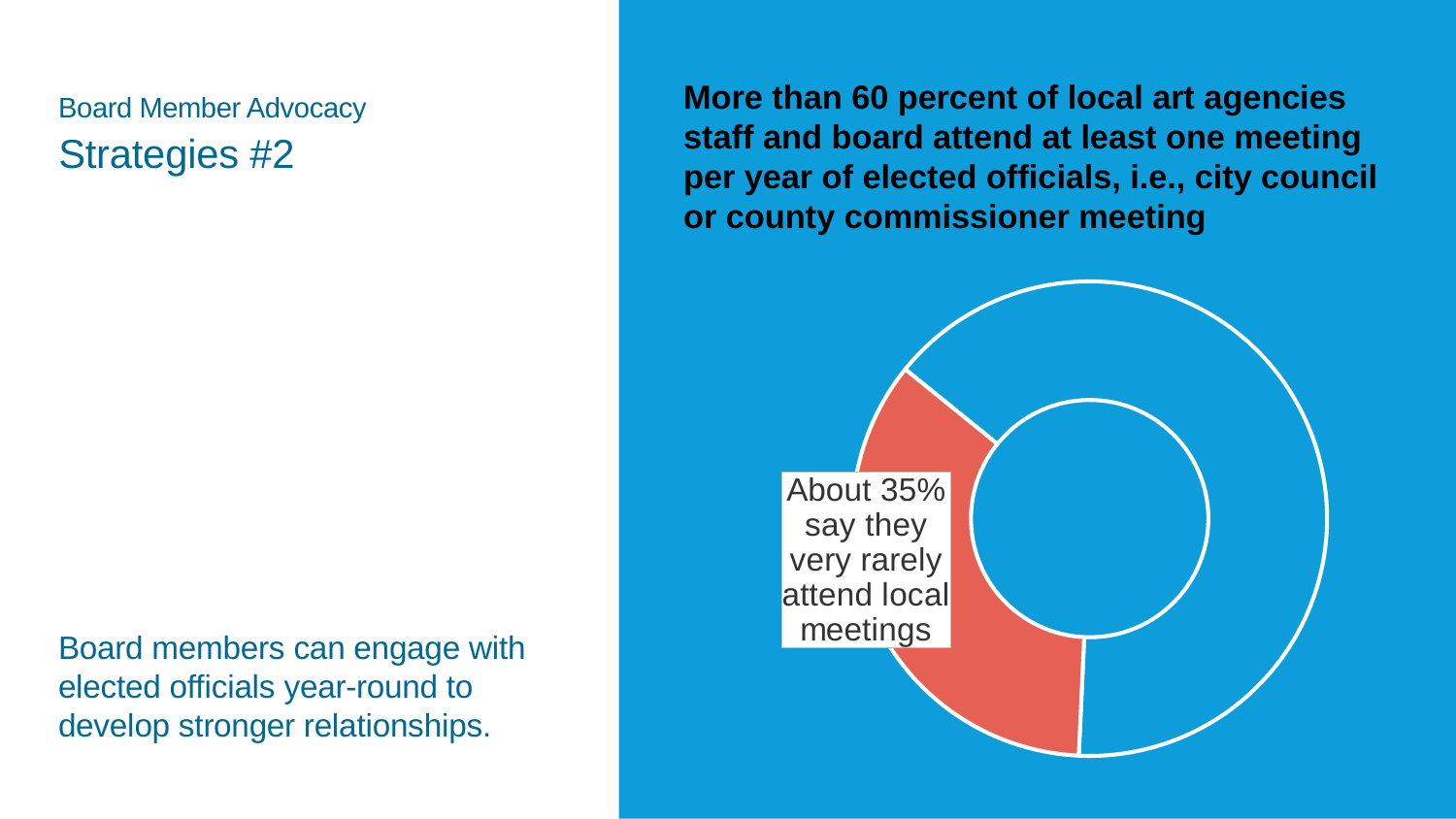
How many segments does the doughnut chart have? 2 What kind of chart is shown on the slide? doughnut chart What colour is the segment representing those who very rarely attend local meetings? red Which segment of the doughnut chart is larger, the blue one or the red one? the blue one What does the label on the red segment of the doughnut chart say? About 35% say they very rarely attend local meetings Does the red segment of the doughnut chart represent more or less than half of the whole? less